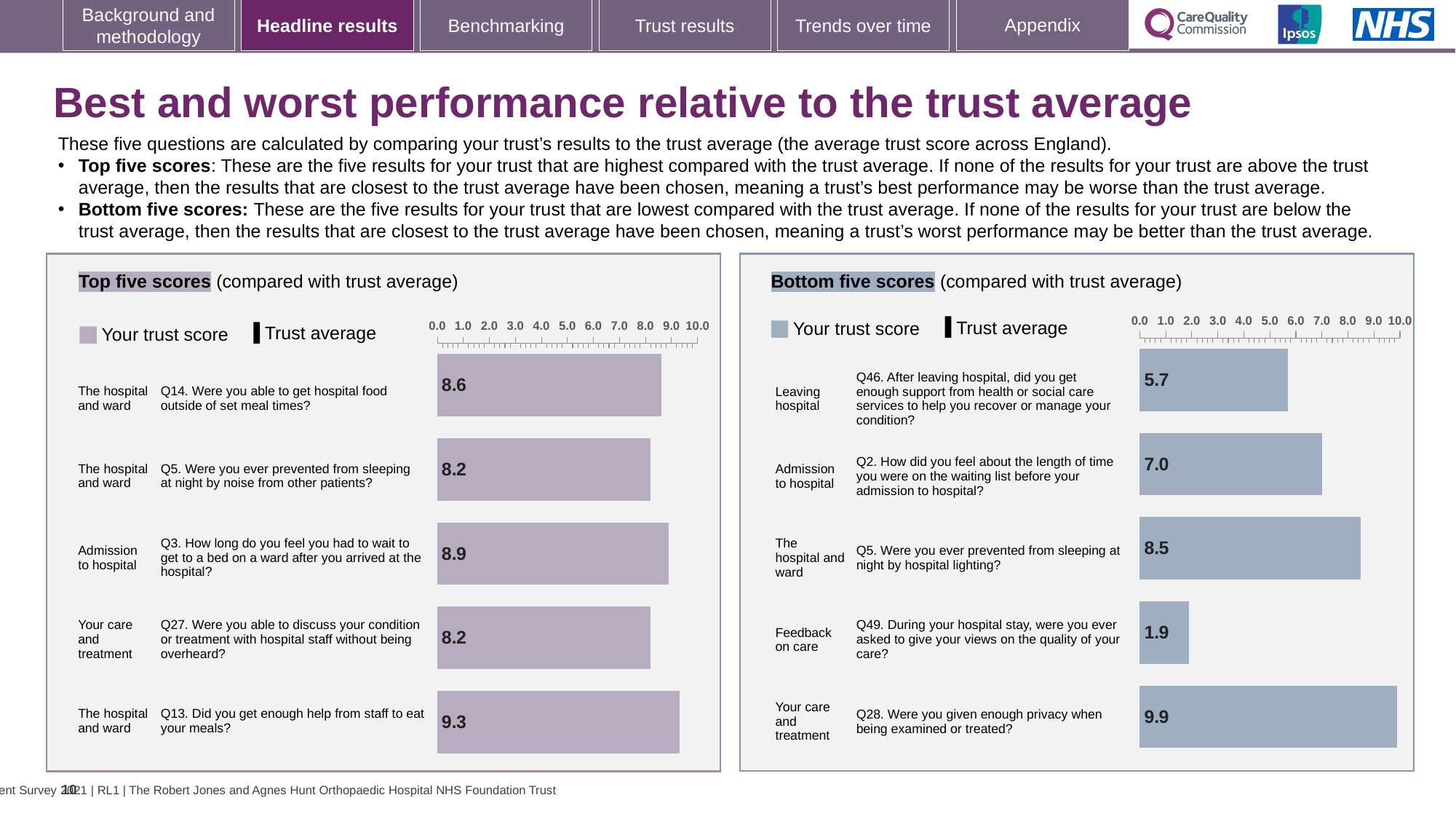
In the Bottom five scores chart, which question has the lowest trust score? Q49. During your hospital stay, were you ever asked to give your views on the quality of your care? In the Top five scores chart, which question has the highest trust score? Q13. Did you get enough help from staff to eat your meals? In the Bottom five scores chart, what is the difference between the trust scores for Q28 and Q49? 8.0 In the Bottom five scores chart, which has the larger trust score: Q2 (length of time on the waiting list) or Q5 (prevented from sleeping by hospital lighting)? Q5 What type of chart is used in the Top five scores panel? Bar chart In the Bottom five scores chart, which question has the highest trust score? Q28. Were you given enough privacy when being examined or treated? In the Top five scores chart, what is the difference between the trust scores for Q13 and Q5? 1.1 How many questions are shown in the Bottom five scores chart? 5 In the Bottom five scores chart, what is the trust score for Q49 (During your hospital stay, were you ever asked to give your views on the quality of your care?)? 1.9 In the Top five scores chart, what is the trust score for Q13 (Did you get enough help from staff to eat your meals?)? 9.3 In the Bottom five scores chart, what is the trust score for Q46 (After leaving hospital, did you get enough support from health or social care services?)? 5.7 In the Top five scores chart, what is the trust score for Q3 (How long do you feel you had to wait to get to a bed on a ward after you arrived at the hospital?)? 8.9